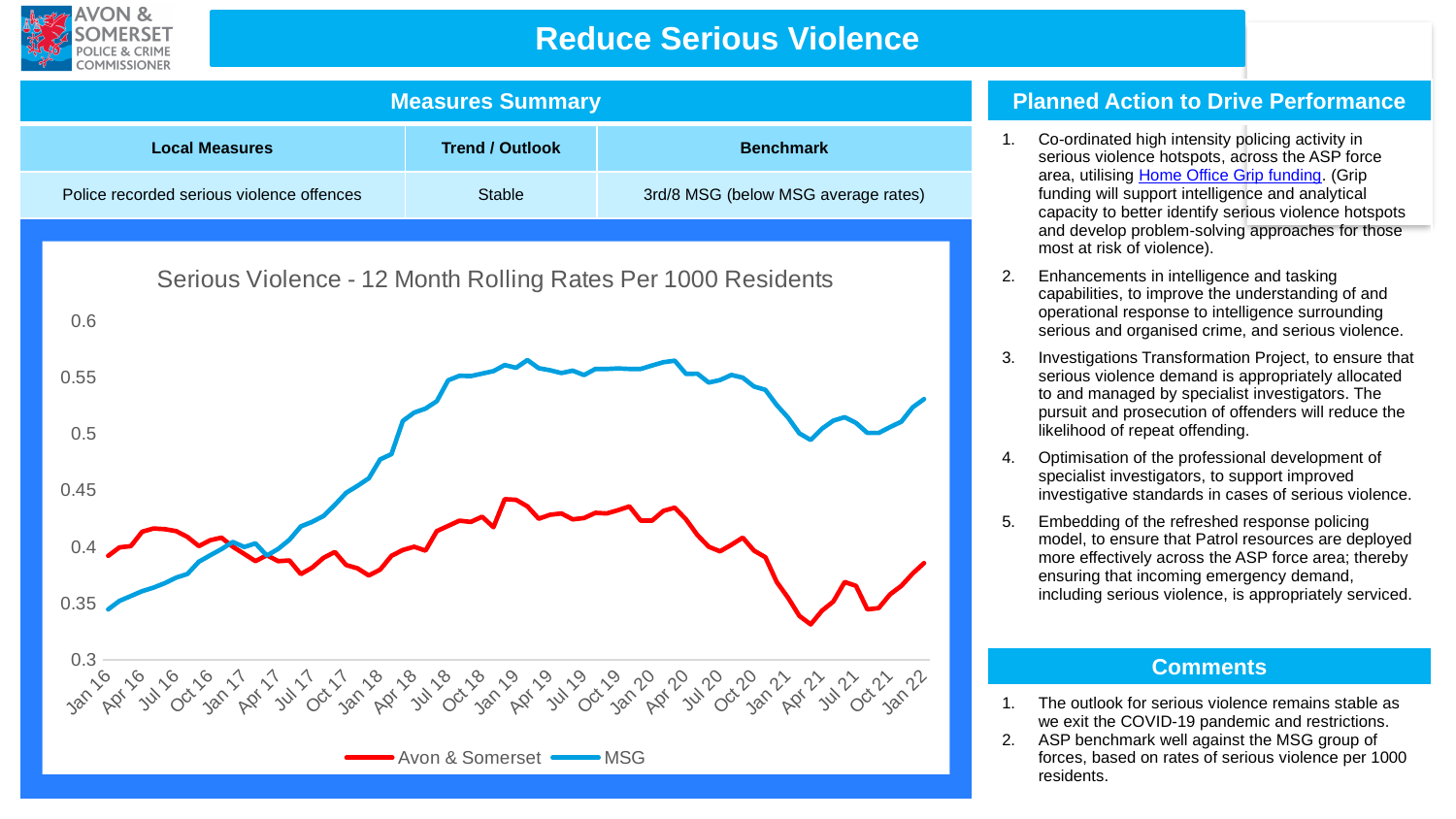
At Jan 19, which series has the higher value, Avon & Somerset or MSG? MSG Which series is drawn in red on the chart? Avon & Somerset Is the MSG value at Jan 16 greater or less than 0.4? less What is the title of the chart? Serious Violence - 12 Month Rolling Rates Per 1000 Residents Is the Avon & Somerset value at Jan 19 greater or less than 0.5? less What kind of chart is shown on the slide? line chart How many series does the chart legend list? 2 Does the Avon & Somerset series rise or fall between Jan 20 and Apr 21? fall Is the MSG value at Jan 19 greater or less than 0.5? greater At Jan 16, which series has the higher value, Avon & Somerset or MSG? Avon & Somerset Does the MSG series rise or fall between Jan 16 and Jan 19? rise